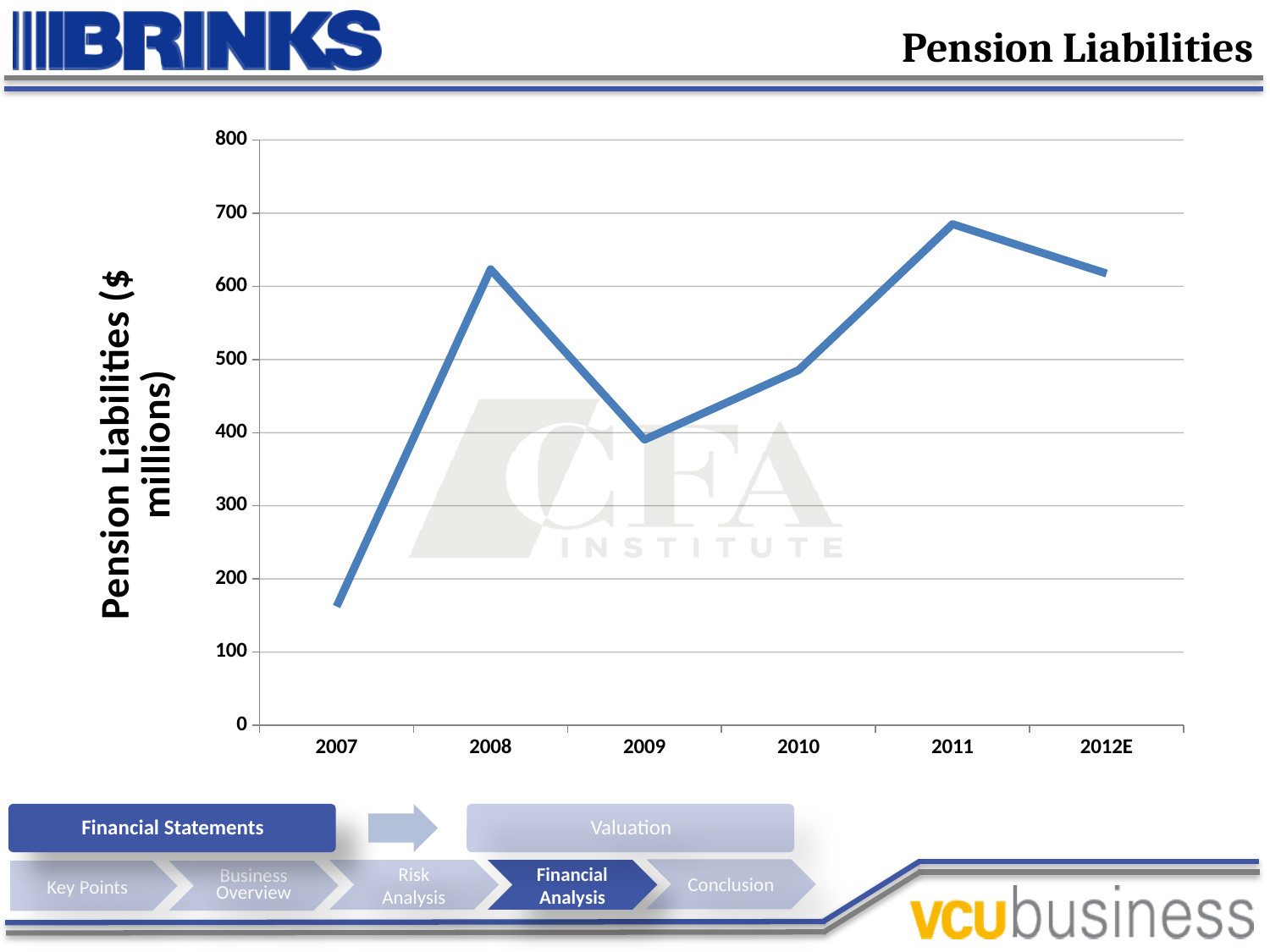
Is the value for 2012E greater or less than 500? greater What is the label on the vertical axis of the chart? Pension Liabilities ($ millions) How many years are plotted on the x axis of the chart? 6 Is the value for 2007 greater or less than 200? less What kind of chart is shown on the slide? line chart Which year has the lowest pension liabilities in the chart? 2007 Is the value for 2011 greater or less than 600? greater Which year has higher pension liabilities, 2009 or 2010? 2010 Which year has the highest pension liabilities in the chart? 2011 Do pension liabilities rise or fall from 2011 to 2012E? fall